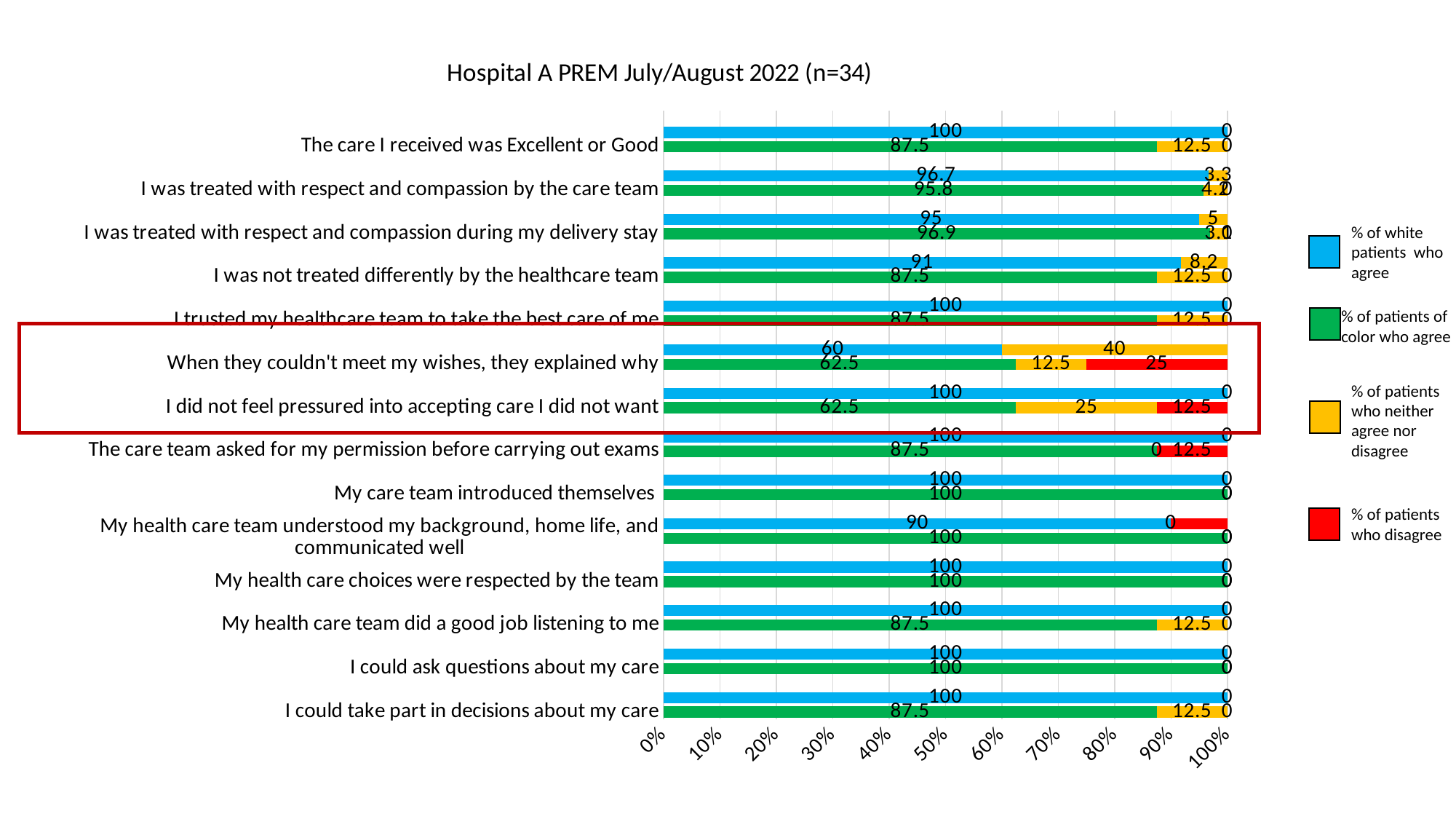
Which statement has the lowest percentage of white patients who agree? When they couldn't meet my wishes, they explained why What kind of chart is shown on the slide? bar chart For "When they couldn't meet my wishes, they explained why", what percentage of white patients neither agreed nor disagreed? 40 What percentage of patients of color agreed with "I did not feel pressured into accepting care I did not want"? 62.5 What is the title of the chart? Hospital A PREM July/August 2022 (n=34) For "I did not feel pressured into accepting care I did not want", what is the difference between the percentage of white patients who agree and the percentage of patients of color who agree? 37.5 How many series does the legend list? 4 For "When they couldn't meet my wishes, they explained why", what percentage of patients of color disagreed? 25 What percentage of white patients agreed with "When they couldn't meet my wishes, they explained why"? 60 What percentage of white patients agreed with "My health care team understood my background, home life, and communicated well"? 90 How many statements (categories) are listed on the y axis of the chart? 14 For "I was treated with respect and compassion during my delivery stay", which group has the higher percentage who agree: white patients or patients of color? patients of color